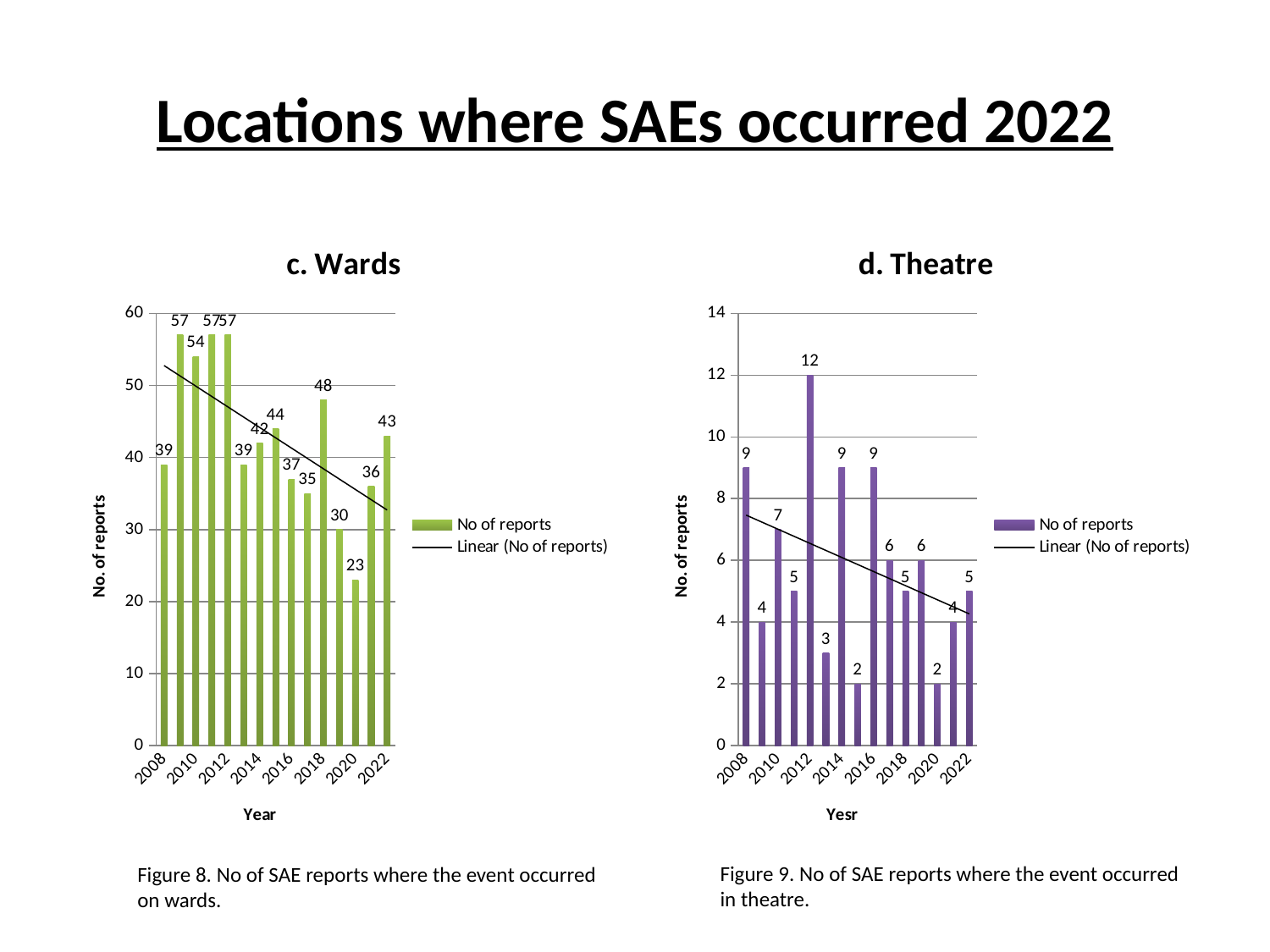
In the d. Theatre chart, what is the number of reports for 2012? 12 In the c. Wards chart, what is the number of reports for 2020? 23 In the c. Wards chart, what is the number of reports for 2010? 54 In the d. Theatre chart, which year has more reports, 2008 or 2010? 2008 In the d. Theatre chart, which year has the highest number of reports? 2012 In the d. Theatre chart, what is the number of reports for 2020? 2 What type of chart is the d. Theatre chart? Bar chart How many bars (years) are plotted in the c. Wards chart? 15 In the d. Theatre chart, does the linear trend line rise or fall from 2008 to 2022? Fall In the c. Wards chart, what is the number of reports for 2022? 43 In the c. Wards chart, what is the difference between the number of reports in 2022 and in 2008? 4 In the c. Wards chart, which year has the lowest number of reports? 2020